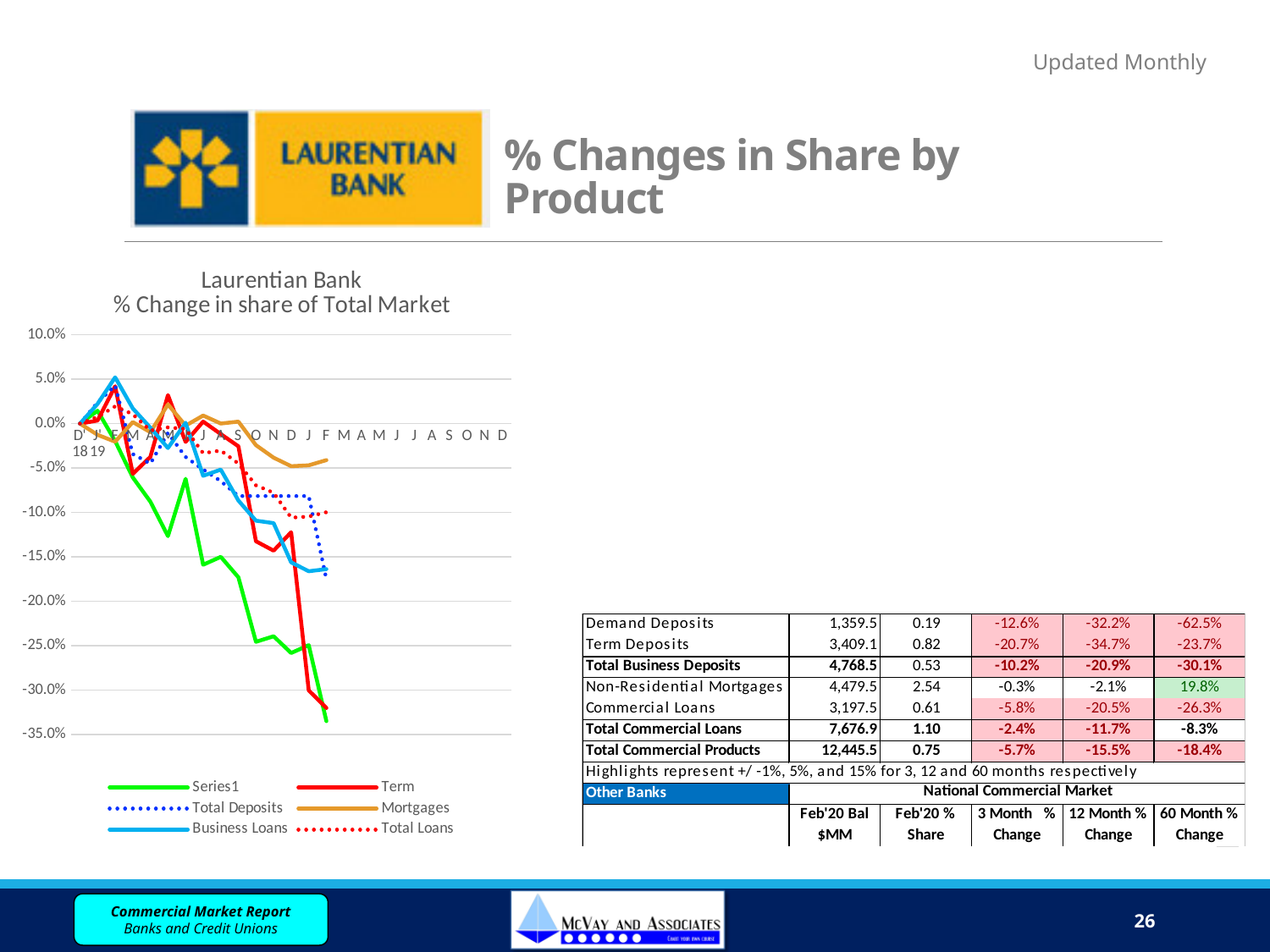
At the right end of the chart, is the value for Mortgages larger or smaller than the value for Series1? larger What kind of chart is shown on the slide? line chart Which series ends at the lowest value at the right end of the chart? Series1 Does Series1 generally rise or fall along the x axis? fall Is the final value of Term greater or less than -25.0%? less Which series ends at the highest value at the right end of the chart? Mortgages Is the final value of Series1 greater or less than -30.0%? less Which colour is used for the Mortgages series in the chart? orange Is the final value of Total Deposits greater or less than -10.0%? less What is the title of the chart? Laurentian Bank % Change in share of Total Market How many series does the legend of the chart list? 6